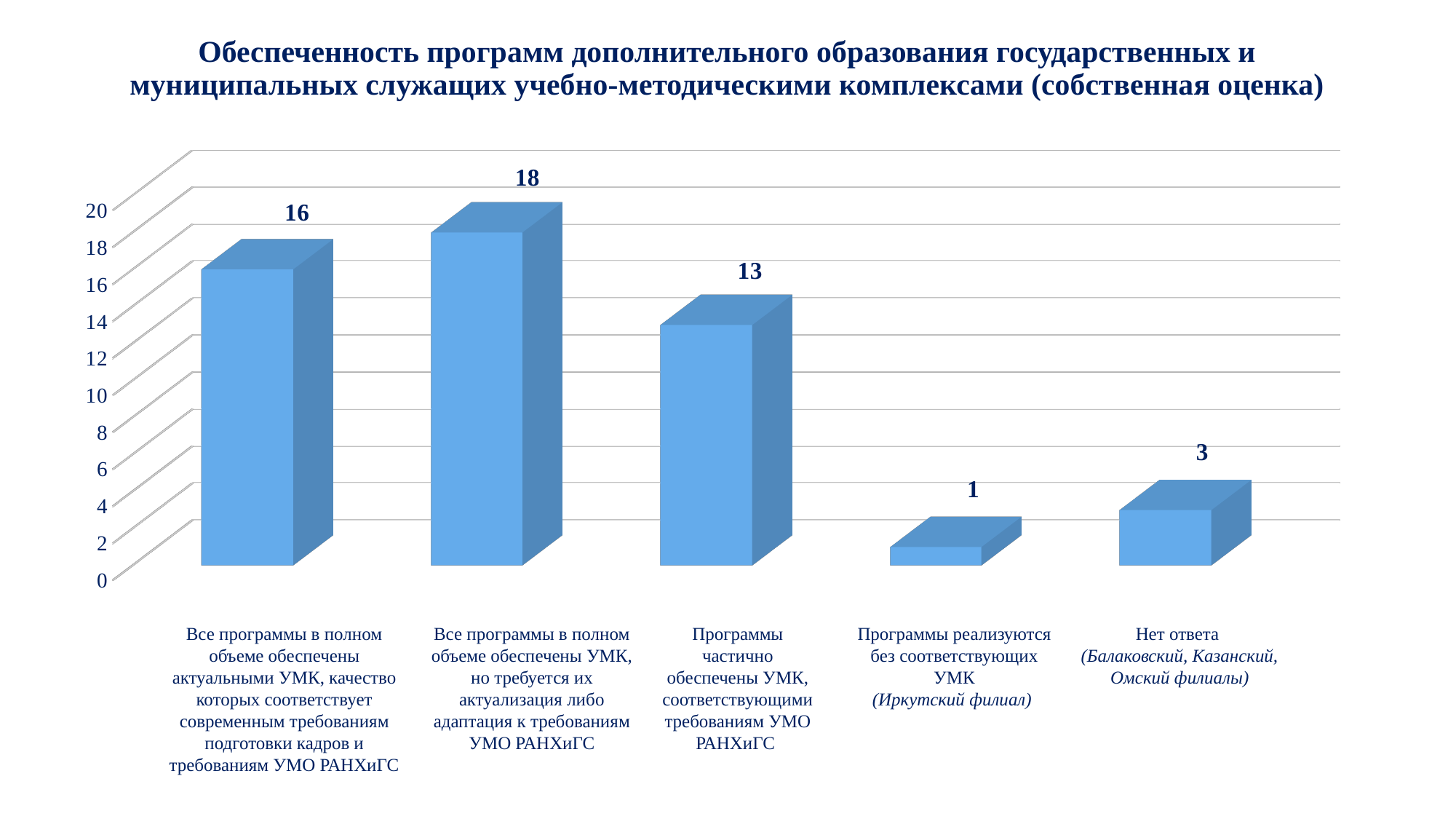
What is the difference between the values for 'Все программы в полном объеме обеспечены УМК, но требуется их актуализация...' and 'Все программы в полном объеме обеспечены актуальными УМК...'? 2 Is the value for 'Нет ответа' greater or less than 10? less What is the value for 'Программы реализуются без соответствующих УМК (Иркутский филиал)'? 1 What kind of chart is shown on the slide? Bar chart What is the difference between the values for 'Программы частично обеспечены УМК...' and 'Нет ответа'? 10 Which category has the highest value? Все программы в полном объеме обеспечены УМК, но требуется их актуализация либо адаптация к требованиям УМО РАНХиГС What is the value for 'Программы частично обеспечены УМК, соответствующими требованиям УМО РАНХиГС'? 13 Which category has the lowest value? Программы реализуются без соответствующих УМК (Иркутский филиал) How many categories are shown on the chart? 5 What is the value for the category 'Нет ответа'? 3 Which is larger: the value for 'Все программы в полном объеме обеспечены актуальными УМК...' or the value for 'Программы частично обеспечены УМК...'? Все программы в полном объеме обеспечены актуальными УМК... What is the maximum value shown on the vertical axis? 20